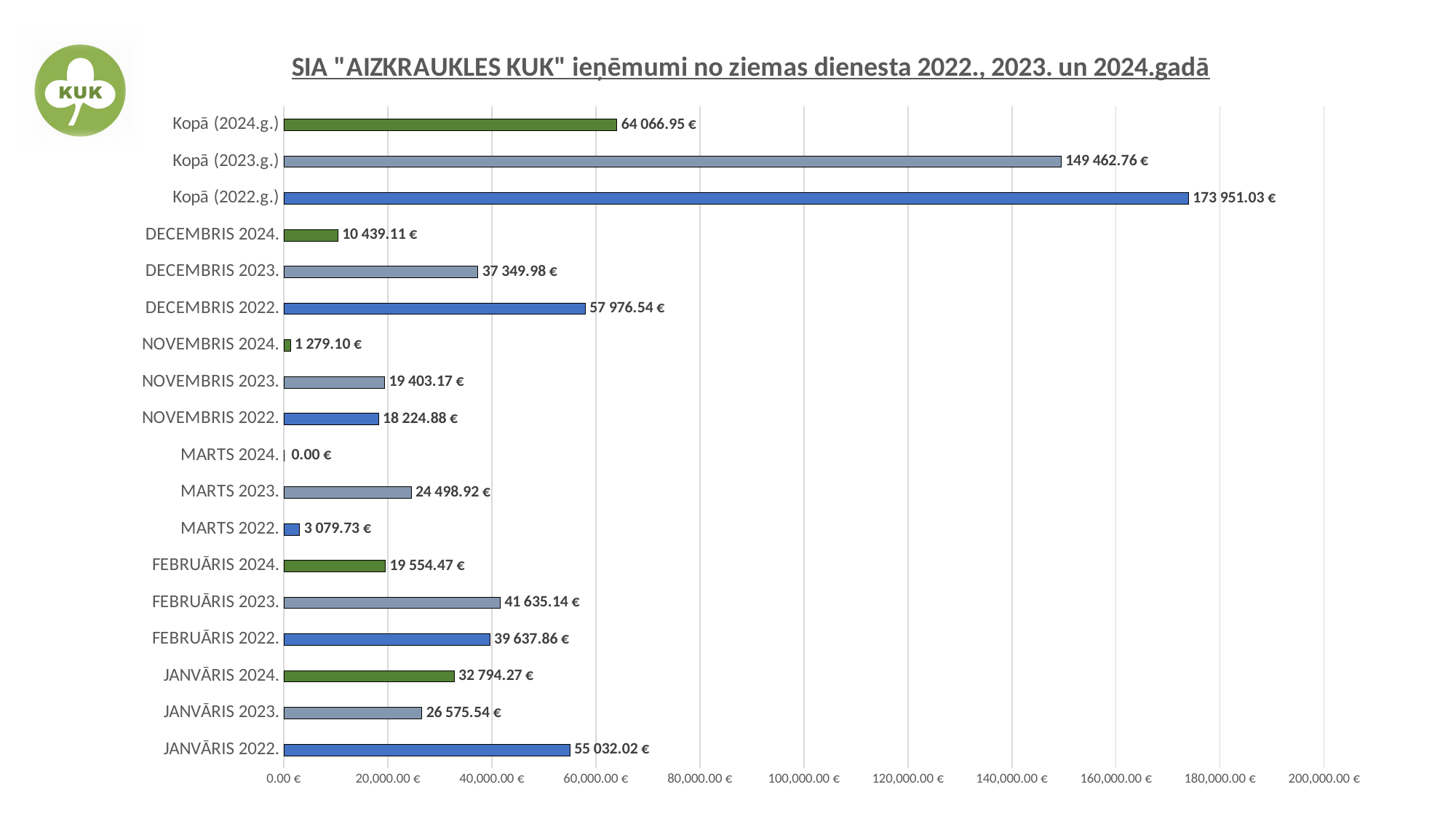
Which category has the lowest value? MARTS 2024. What is the value for NOVEMBRIS 2024.? 1 279.10 € What is the value for DECEMBRIS 2023.? 37 349.98 € What is the value for Kopā (2022.g.)? 173 951.03 € What is the difference between DECEMBRIS 2022. and DECEMBRIS 2023.? 20 626.56 € What is the value for JANVĀRIS 2022.? 55 032.02 € What kind of chart is shown on the slide? bar chart Which is larger, FEBRUĀRIS 2023. or FEBRUĀRIS 2022.? FEBRUĀRIS 2023. How many categories are shown on the chart? 18 What is the difference between Kopā (2022.g.) and Kopā (2023.g.)? 24 488.27 € Is the value for Kopā (2023.g.) greater or less than 140,000.00 €? greater Which category has the highest value? Kopā (2022.g.)